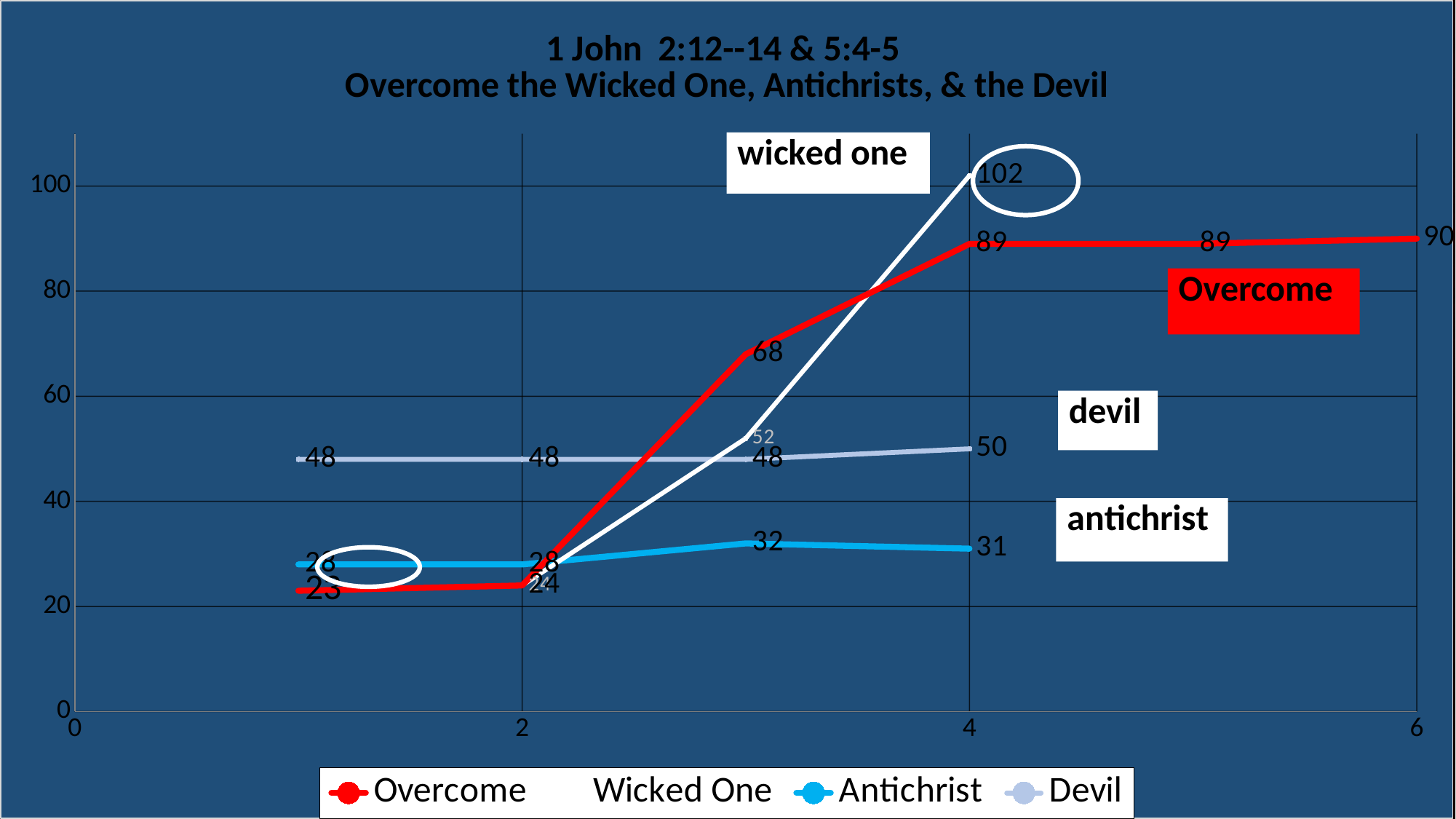
What is the value of the Overcome series at x = 6? 90 What is the value of the Devil series at x = 4? 50 At x = 4, which is larger: the Overcome value or the Devil value? Overcome What is the value of the Wicked One series at x = 4? 102 How many series does the legend list? 4 At x = 4, what is the difference between the Wicked One value and the Overcome value? 13 What kind of chart is shown on the slide? line chart Which series reaches the highest value on the chart? Wicked One At x = 4, what is the difference between the Overcome value and the Antichrist value? 58 What is the value of the Antichrist series at x = 3? 32 Does the Overcome series rise or fall from x = 1 to x = 6? rise What is the value of the Overcome series at x = 3? 68